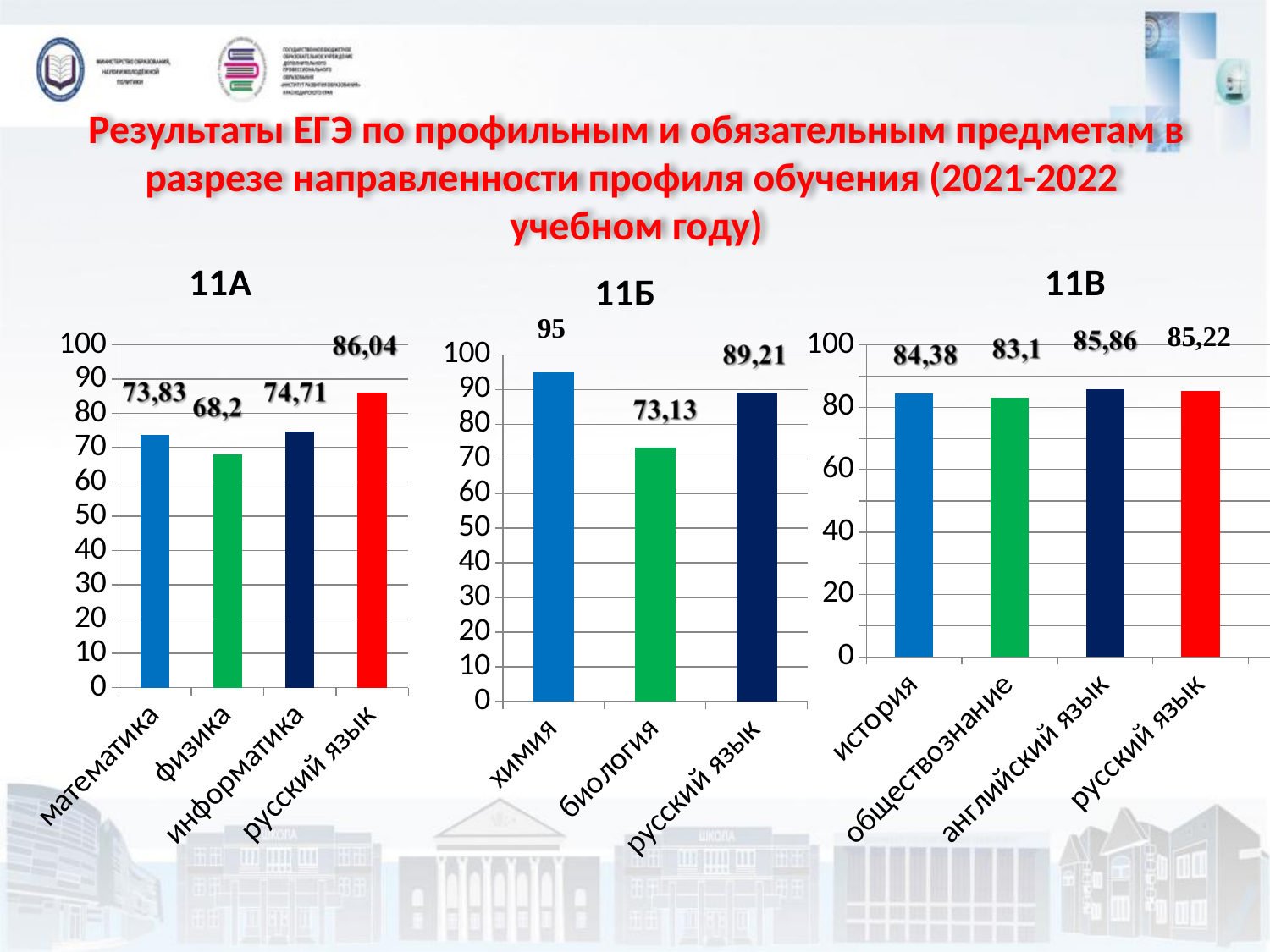
In the 11Б chart, what is the value for химия? 95 In the 11А chart, what is the value for физика? 68,2 In the 11А chart, what is the difference between русский язык and физика? 17,84 In the 11Б chart, how many categories are plotted? 3 In the 11В chart, which category has the highest value? английский язык In the 11В chart, which is larger: история or русский язык? русский язык What kind of chart is the 11Б chart? bar chart How many charts are shown on the slide? 3 In the 11А chart, which category has the highest value? русский язык In the 11Б chart, which category has the lowest value? биология In the 11А chart, is the value for информатика greater or less than 70? greater In the 11В chart, what is the value for обществознание? 83,1